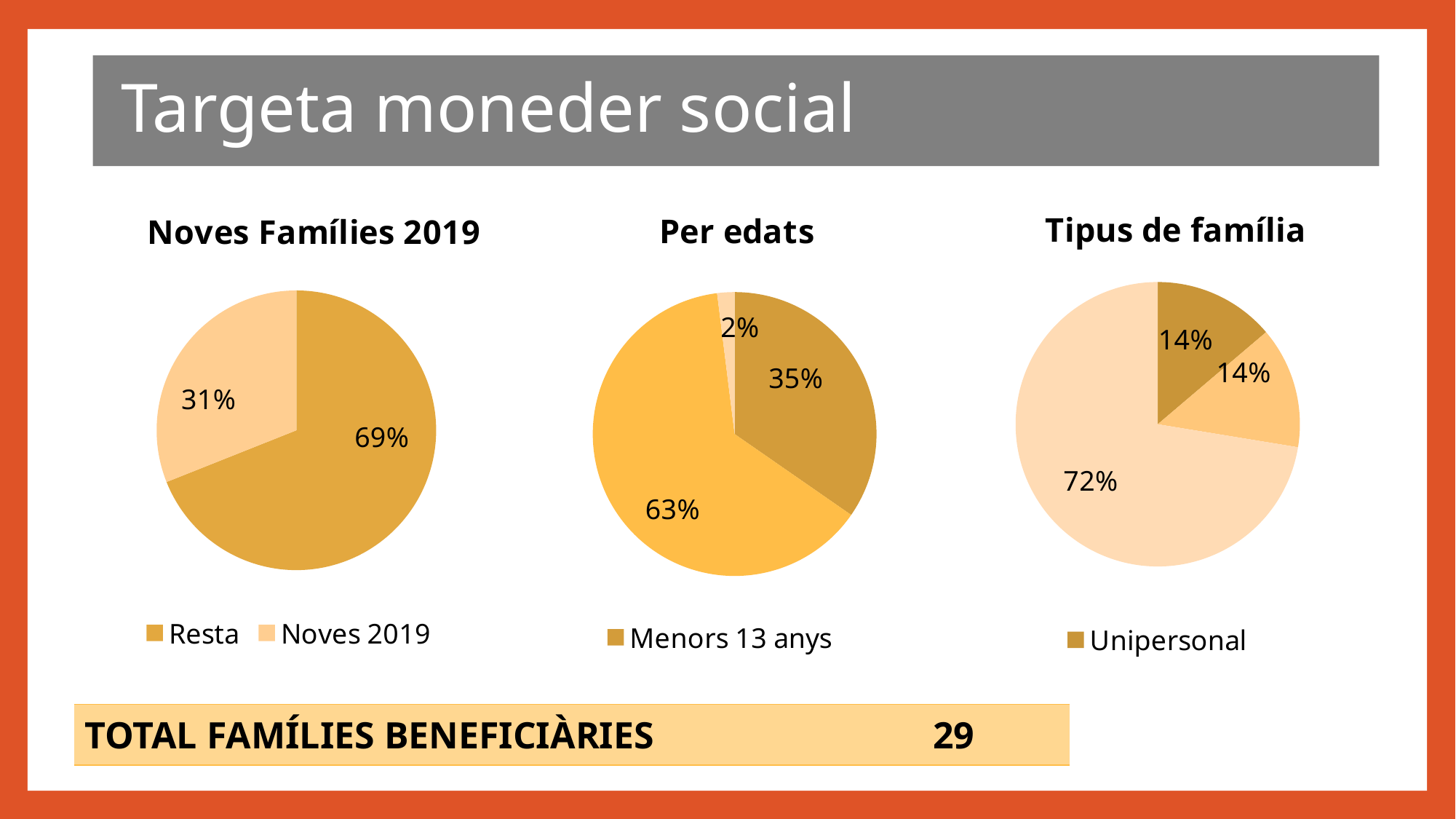
In the 'Noves Famílies 2019' pie chart, what is the difference between the 'Resta' and 'Noves 2019' shares? 38% In the 'Per edats' pie chart, what is the smallest share shown? 2% In the 'Noves Famílies 2019' pie chart, how many slices are there? 2 In the 'Tipus de família' pie chart, what share does 'Unipersonal' have? 14% In the 'Per edats' pie chart, what share does 'Menors 13 anys' have? 35% In the 'Noves Famílies 2019' pie chart, what share does 'Resta' have? 69% In the 'Per edats' pie chart, how many slices are there? 3 In the 'Noves Famílies 2019' pie chart, which slice is the largest? Resta What kind of chart is the 'Tipus de família' chart? Pie chart In the 'Tipus de família' pie chart, what is the largest share shown? 72% How many entries does the legend of the 'Noves Famílies 2019' chart list? 2